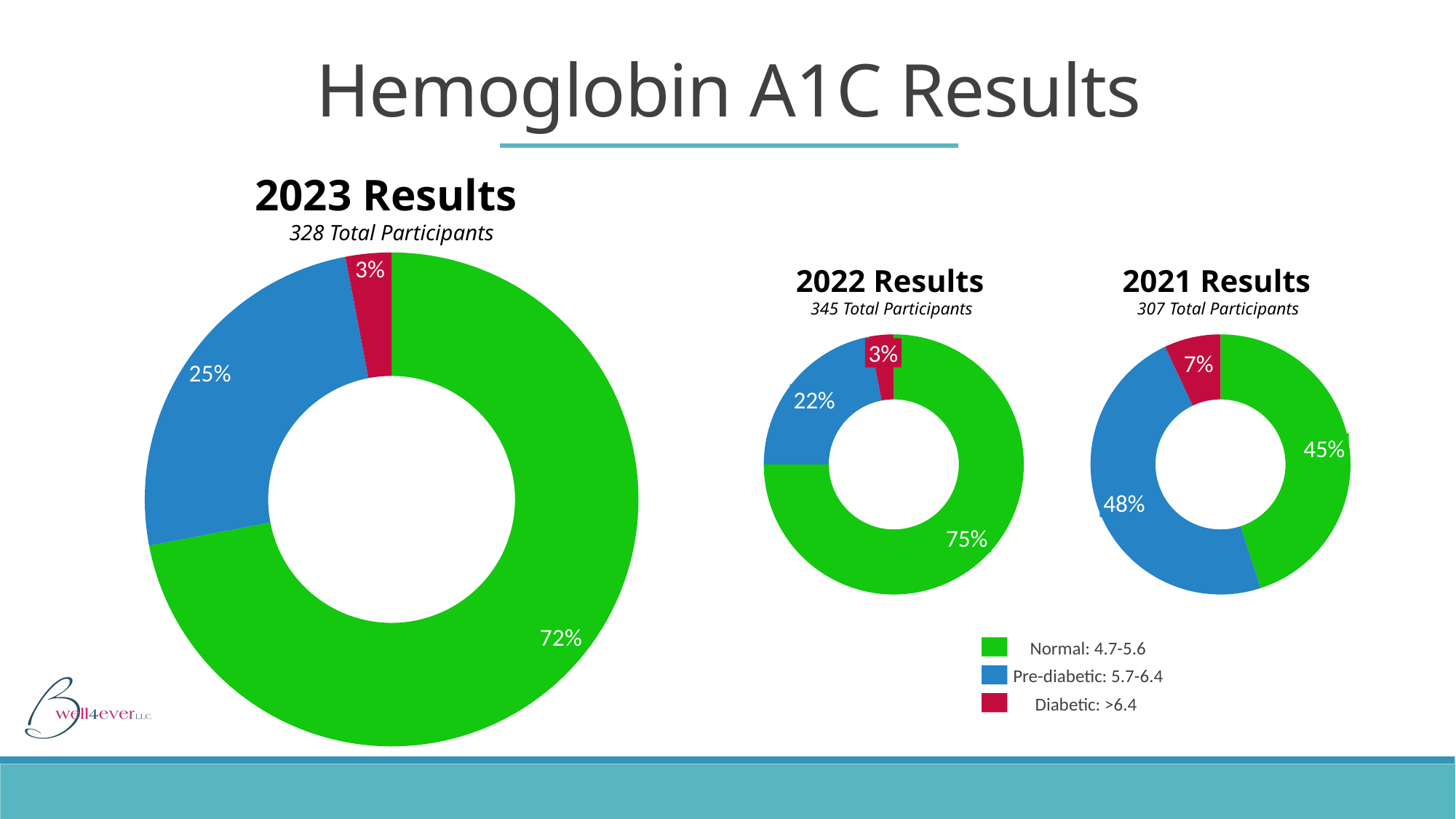
Is the Diabetic share larger in the 2021 Results chart or the 2022 Results chart? 2021 Results In the 2023 Results chart, what percentage of participants were Normal? 72% In the 2022 Results chart, what percentage of participants were Diabetic? 3% What kind of chart is used for the 2023 Results? Doughnut chart In the 2023 Results chart, what is the difference between the Normal and Pre-diabetic shares? 47% Which colour represents the Diabetic category in the legend? Red In the 2022 Results chart, which category has the smallest share? Diabetic In the 2021 Results chart, what percentage of participants were Pre-diabetic? 48% In the 2021 Results chart, which category has the largest share? Pre-diabetic How many total participants does the 2022 Results chart report? 345 In the 2023 Results chart, what percentage of participants were Pre-diabetic? 25% How many categories does each chart show? 3